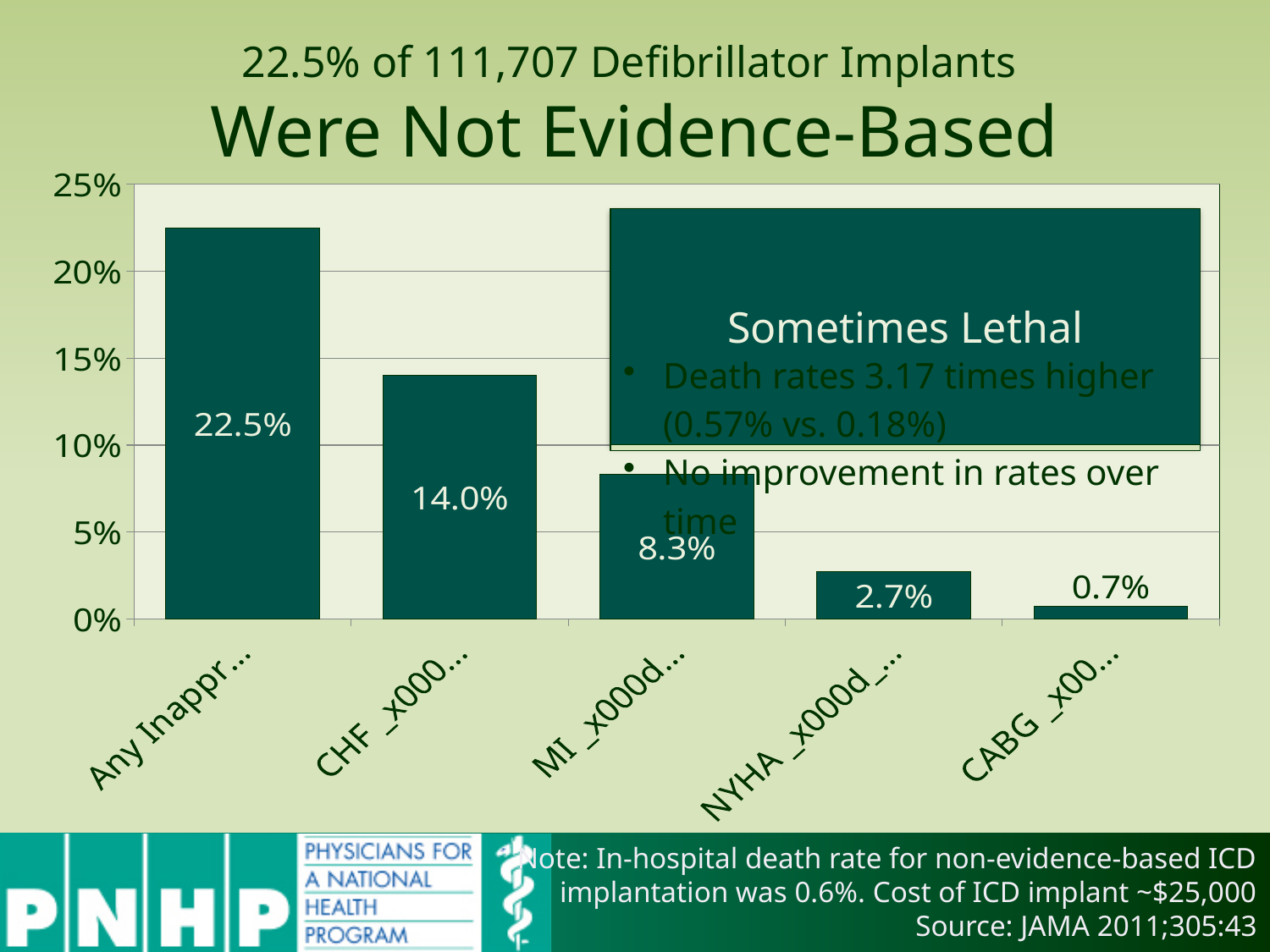
What type of chart is shown on the slide? bar chart What is the difference between the "Any Inappr..." bar and the "CHF" bar? 8.5% Do the bar values rise or fall from left to right along the x axis? fall Which is larger, the value for the "MI" bar or the "NYHA" bar? MI What is the value of the bar whose label begins with "CABG"? 0.7% What is the value of the bar whose label begins with "CHF"? 14.0% What is the value of the bar whose label begins with "NYHA"? 2.7% Which bar has the highest value? Any Inappr... What is the value of the bar whose label begins with "MI"? 8.3% Which bar has the lowest value? CABG How many bars are plotted in the chart? 5 What is the value of the first bar, labelled "Any Inappr..."? 22.5%